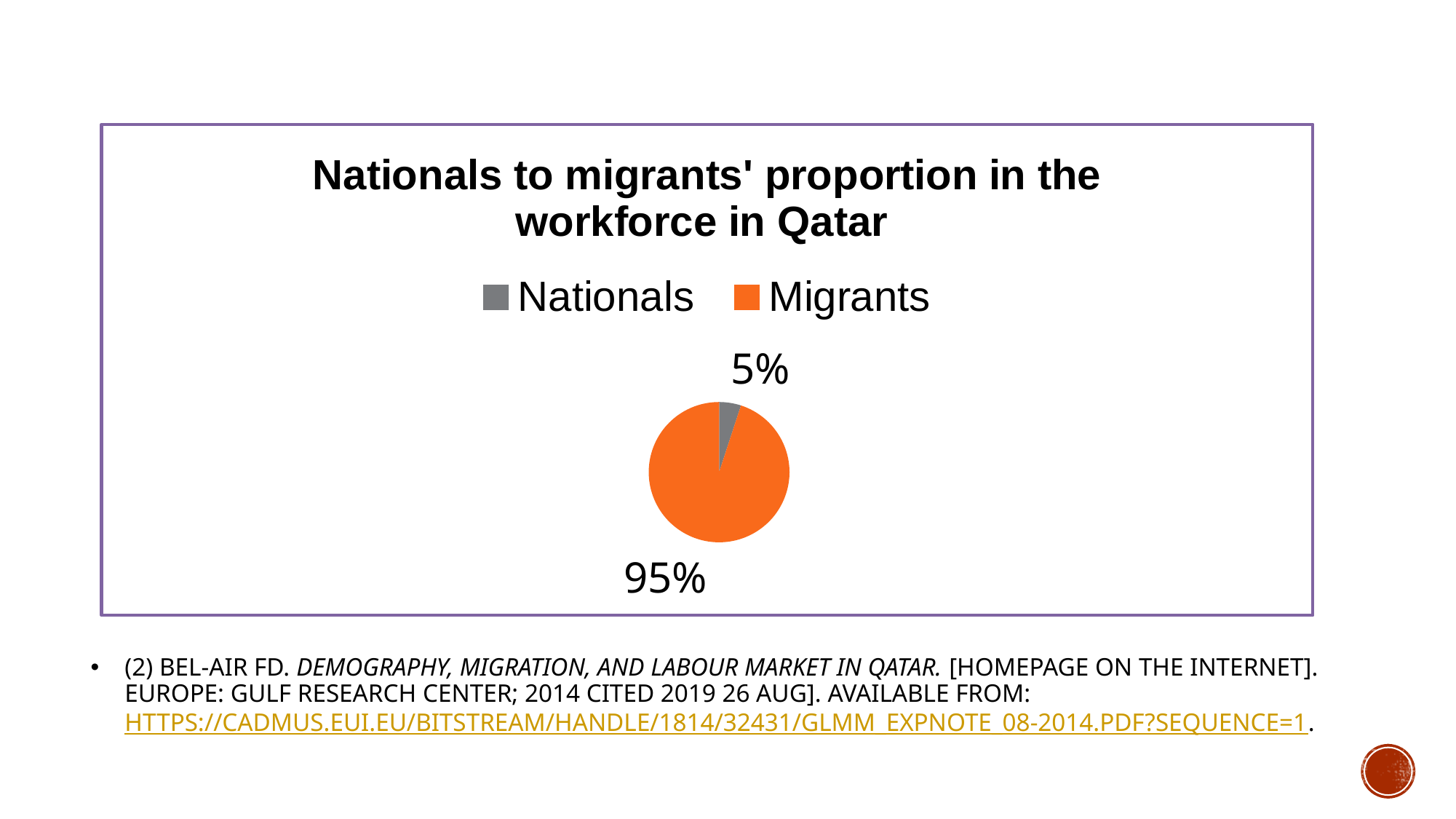
What is the combined share of the Nationals and Migrants slices? 100% What share of the workforce do Nationals make up? 5% How many categories does the pie chart show? 2 Which is larger, the Nationals slice or the Migrants slice? Migrants What is the difference in percentage points between the Migrants and Nationals slices? 90 What kind of chart is shown on the slide? pie chart Which category has the smallest slice of the pie? Nationals What share of the workforce do Migrants make up? 95% What colour is the Migrants slice? orange How many entries does the legend list? 2 Which category has the largest slice of the pie? Migrants What is the title of the chart? Nationals to migrants' proportion in the workforce in Qatar